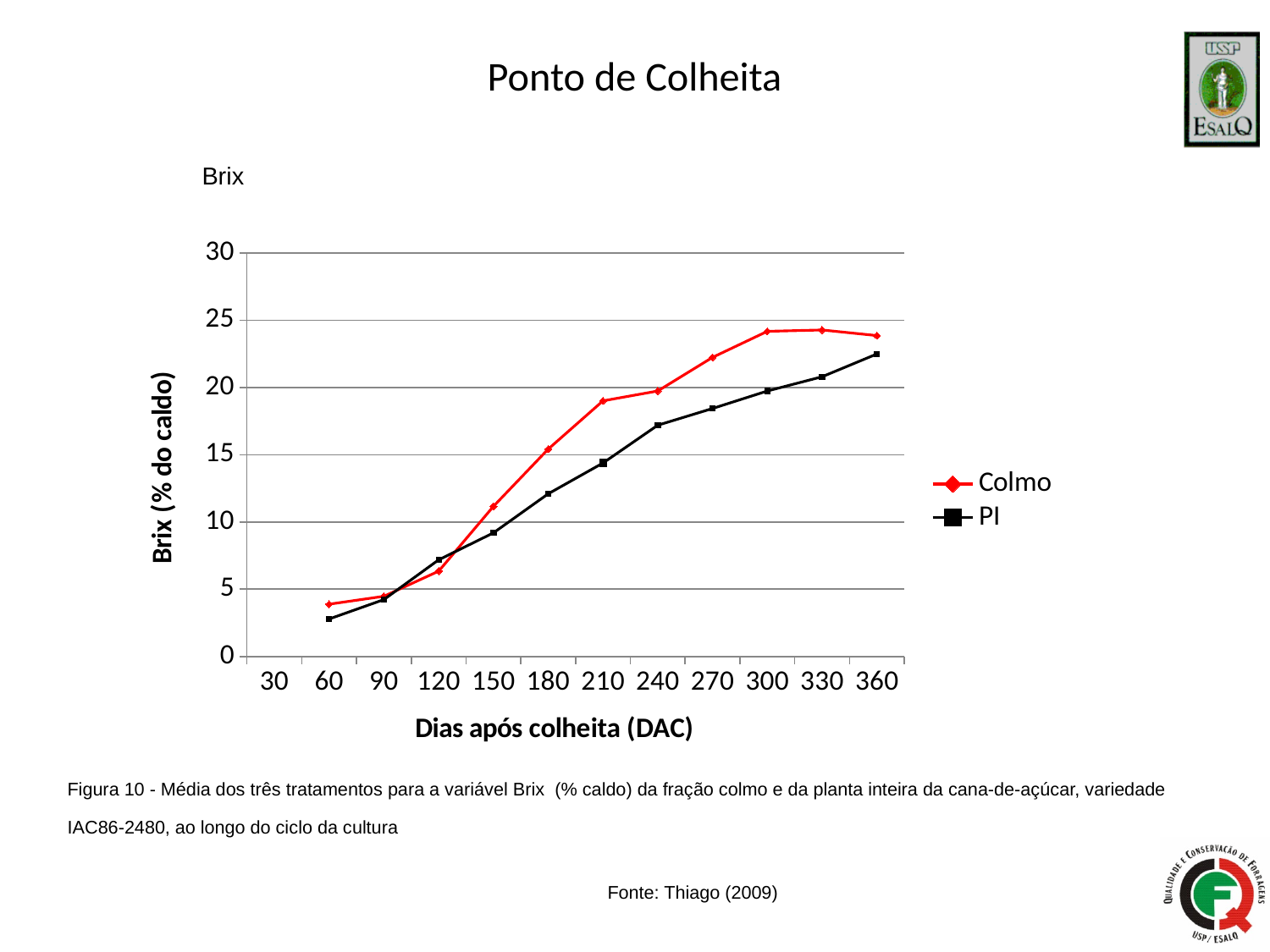
At 120 DAC, which series has the higher Brix value, Colmo or PI? PI Is the PI value at 360 DAC greater or less than 20? greater Is the PI value at 180 DAC greater or less than 15? less What is the label of the x axis? Dias após colheita (DAC) How many series does the legend list? 2 Is the Colmo value at 300 DAC greater or less than 20? greater Does the PI series rise or fall from 60 DAC to 360 DAC? rise What kind of chart is shown on the slide? line chart At 210 DAC, which series has the higher Brix value, Colmo or PI? Colmo Which two series are listed in the legend? Colmo and PI How many data points are plotted for the Colmo series? 11